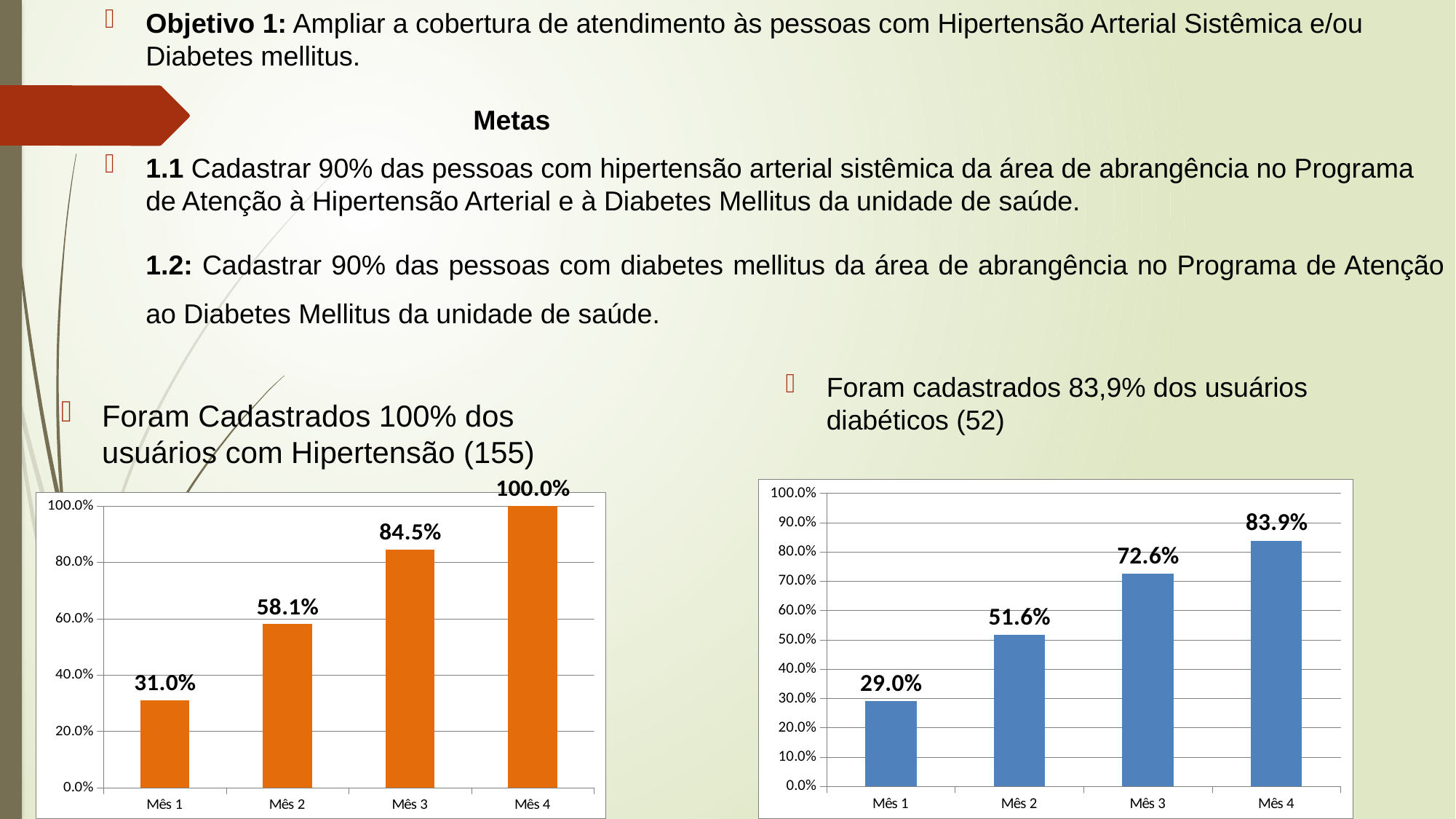
In the left chart (orange bars, hypertension), do the values rise or fall from Mês 1 to Mês 4? Rise What kind of chart is the right chart (blue bars, diabetes)? Bar chart In the right chart (blue bars, diabetes), which month has the lowest value? Mês 1 In the left chart (orange bars, hypertension), which month has the highest value? Mês 4 Comparing the two charts, which is larger: the Mês 3 value in the left chart or the Mês 3 value in the right chart? Left chart (84.5%) In the right chart (blue bars, diabetes), what is the difference between Mês 2 and Mês 1? 22.6% In the right chart (blue bars, diabetes), what is the value for Mês 3? 72.6% In the right chart (blue bars, diabetes), is the value for Mês 4 greater or less than 90%? less In the left chart (orange bars, hypertension), what is the difference between Mês 4 and Mês 1? 69.0% How many months are shown on the x axis of the left chart (orange bars, hypertension)? 4 What colour are the bars in the right chart (diabetes)? Blue In the left chart (orange bars, hypertension), what is the value for Mês 2? 58.1%